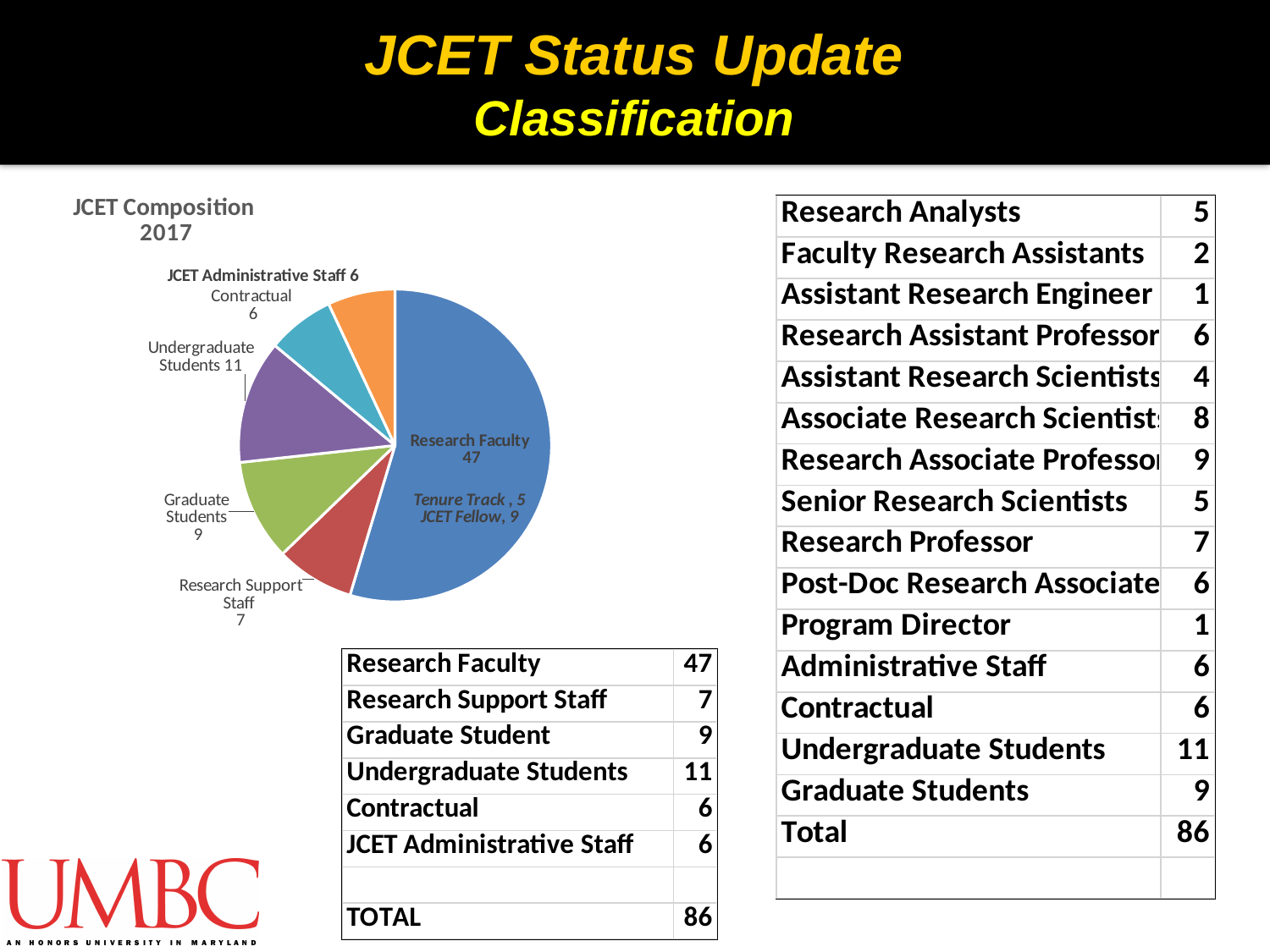
What is the value for Undergraduate Students in the JCET Composition 2017 pie chart? 11 Which category has the largest slice in the JCET Composition 2017 pie chart? Research Faculty In the JCET Composition 2017 pie chart, what is the difference between Research Faculty and Undergraduate Students? 36 What is the value for Research Support Staff in the JCET Composition 2017 pie chart? 7 What type of chart is the JCET Composition 2017 chart? pie chart In the JCET Composition 2017 pie chart, which is larger: Graduate Students or Research Support Staff? Graduate Students What is the title of the pie chart on the slide? JCET Composition 2017 How many slices does the JCET Composition 2017 pie chart have? 6 What is the value for Graduate Students in the JCET Composition 2017 pie chart? 9 In the JCET Composition 2017 pie chart, what is the difference between Undergraduate Students and Graduate Students? 2 What is the value for Research Faculty in the JCET Composition 2017 pie chart? 47 What is the value for Contractual in the JCET Composition 2017 pie chart? 6